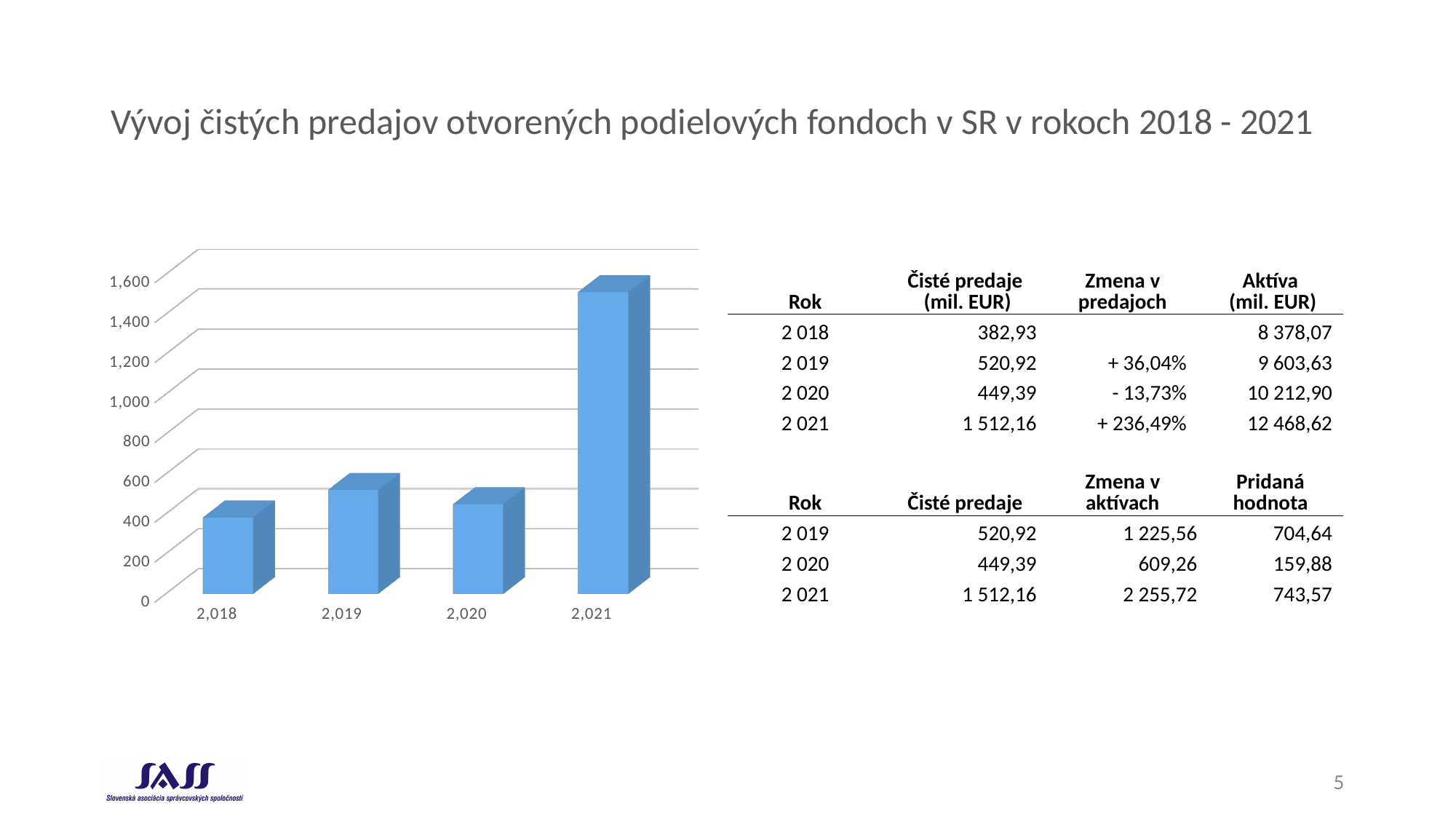
Is the bar for 2,018 greater or less than 600? less Which year has the highest bar in the chart? 2,021 According to the table next to the chart, what is the value of Čisté predaje (mil. EUR) for 2 021? 1 512,16 Is the bar for 2,019 greater or less than 400? greater Which bar is taller, 2,019 or 2,020? 2,019 According to the table next to the chart, what is the value of Čisté predaje (mil. EUR) for 2 018? 382,93 How many years (bars) does the chart show? 4 Which year has the lowest bar in the chart? 2,018 Is the bar for 2,021 greater or less than 1,600? less What kind of chart is shown on the slide? bar chart Does the bar height rise or fall from 2,020 to 2,021? rise